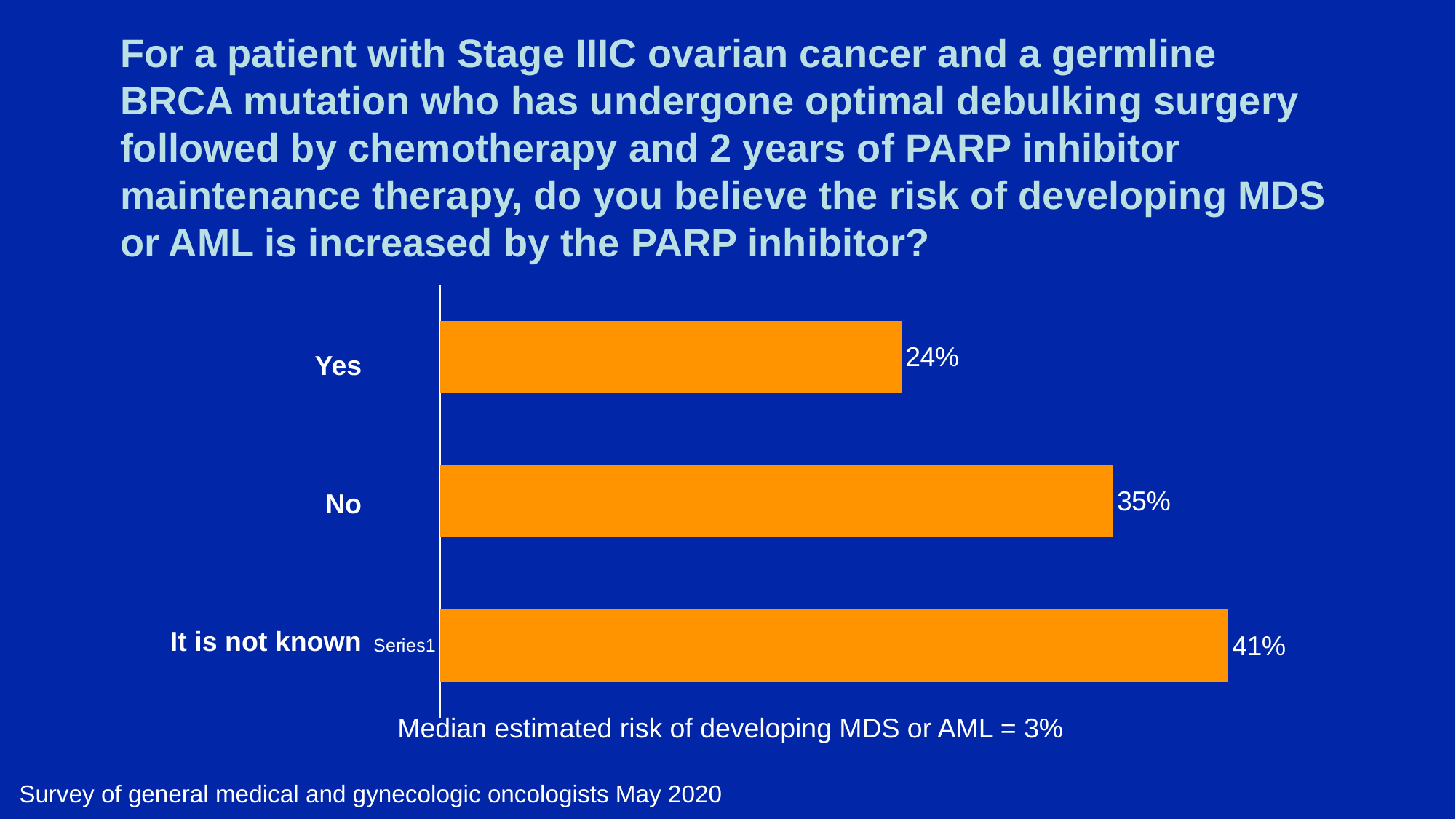
What colour are the bars in the chart? Orange Which response category has the lowest percentage? Yes Which response received a larger share, "No" or "Yes"? No What is the difference in percentage points between "No" and "Yes"? 11 How many response categories are shown in the chart? 3 What percentage of respondents answered "Yes"? 24% What is the median estimated risk of developing MDS or AML stated below the chart? 3% What percentage of respondents answered "It is not known"? 41% Which response category has the highest percentage? It is not known What type of chart is shown on the slide? Bar chart What is the difference in percentage points between "It is not known" and "Yes"? 17 What percentage of respondents answered "No"? 35%